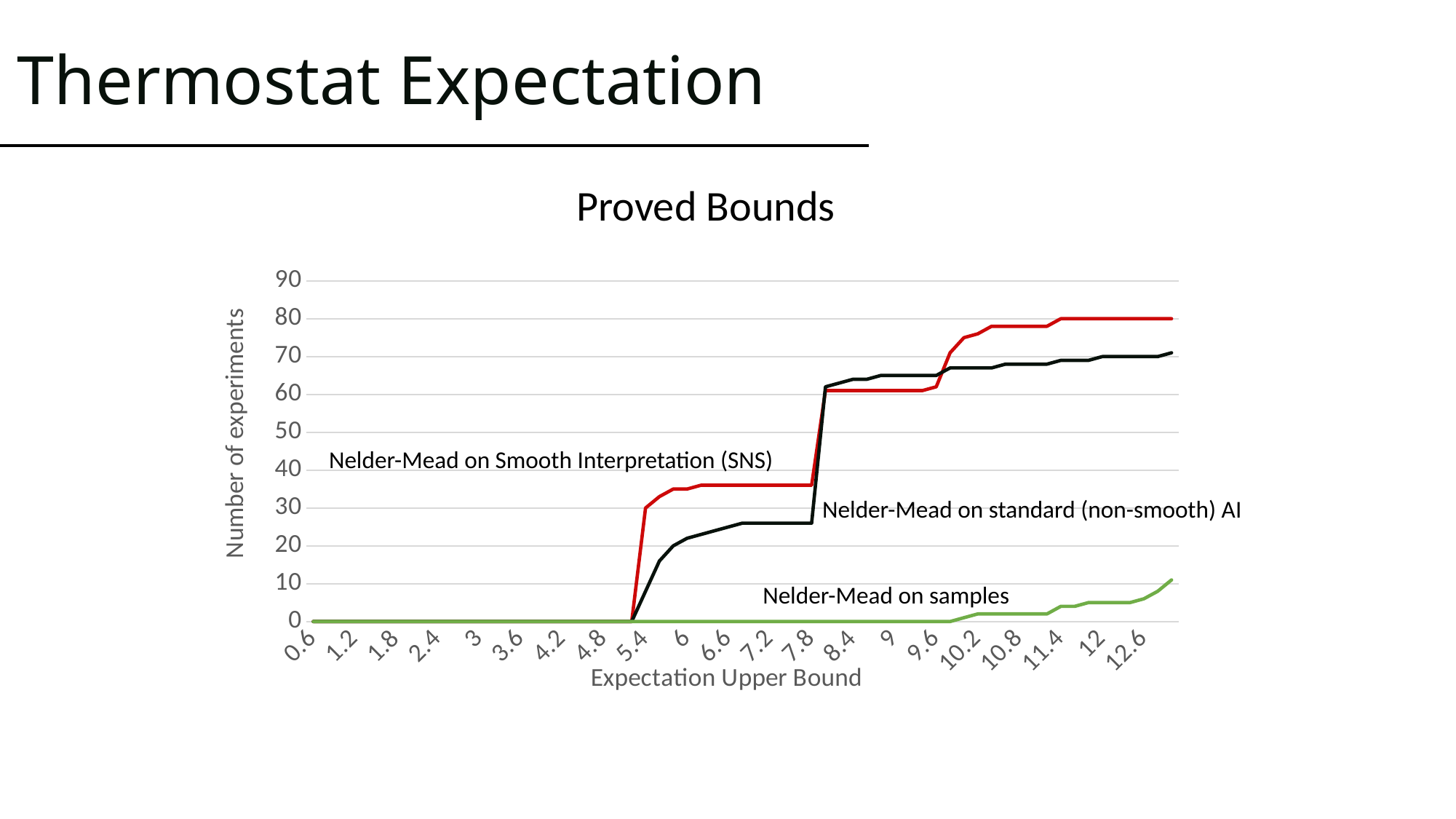
At an expectation upper bound of 12.6, which series has the higher value: Nelder-Mead on Smooth Interpretation (SNS) or Nelder-Mead on standard (non-smooth) AI? Nelder-Mead on Smooth Interpretation (SNS) Is the value for Nelder-Mead on Smooth Interpretation (SNS) at an expectation upper bound of 6.6 greater or less than 30? greater Is the value for Nelder-Mead on Smooth Interpretation (SNS) at an expectation upper bound of 12.6 greater or less than 70? greater What is the title of the chart? Proved Bounds Is the value for Nelder-Mead on standard (non-smooth) AI at an expectation upper bound of 12.6 greater or less than 80? less What kind of chart is shown on the slide? line chart Which series has the lowest value at an expectation upper bound of 12.6? Nelder-Mead on samples What is the label of the x axis? Expectation Upper Bound Does the Nelder-Mead on Smooth Interpretation (SNS) line rise or fall as the expectation upper bound increases? rise How many series are plotted in the chart? 3